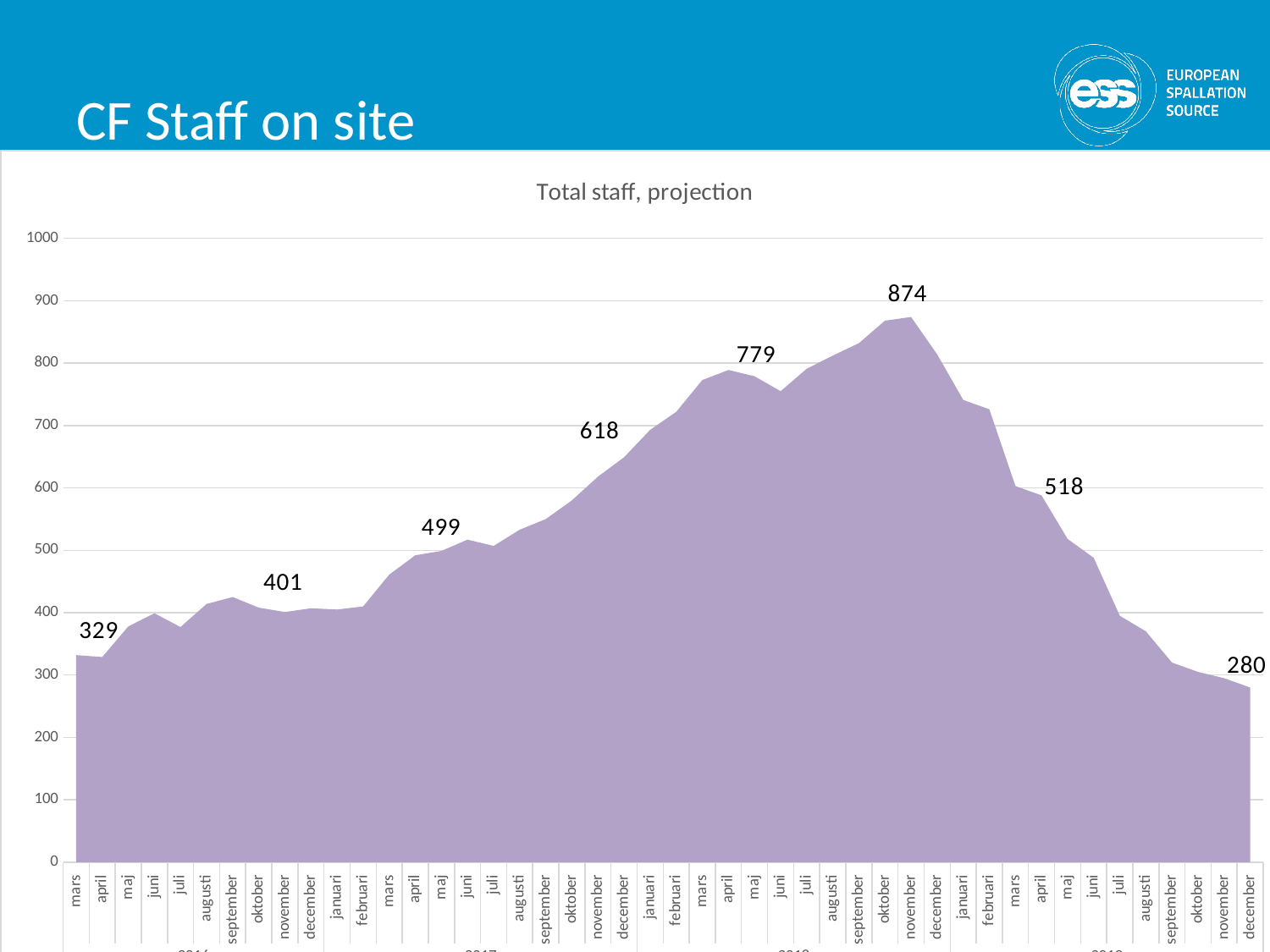
What is the difference between the highest labelled value (874) and the lowest labelled value (280)? 594 What is the highest value labelled on the chart? 874 What value is labelled at the last point on the right of the chart (december)? 280 What is the difference between the labelled values 779 and 618? 161 How many data labels are printed on the chart? 8 What is the lowest value labelled on the chart? 280 What kind of chart is shown on the slide? area chart What is the title of the chart? Total staff, projection Is the peak of the chart greater or less than 900? less Which is larger, the labelled value 499 or the labelled value 518? 518 After the peak of 874, do the values rise or fall towards the right end of the chart? fall